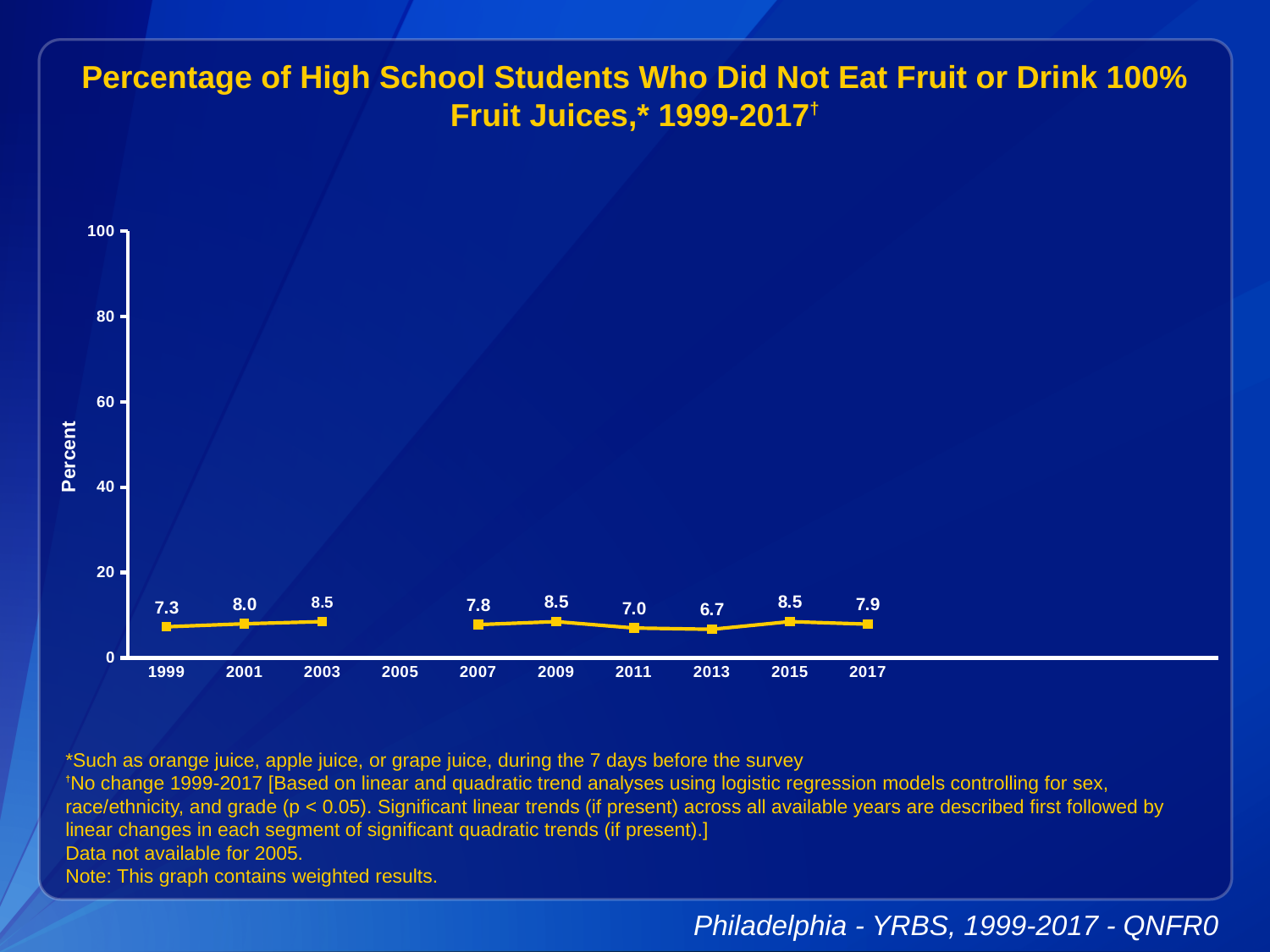
What is the label on the vertical axis? Percent What percentage of high school students did not eat fruit or drink 100% fruit juices in 1999? 7.3 What is the value shown for 2007? 7.8 Is the value for 2009 greater or less than 20? less Which year has the larger value, 2011 or 2015? 2015 What is the value shown for 2013? 6.7 What kind of chart is shown on the slide? line chart What is the difference between the values for 2003 and 1999? 1.2 How many years have a data point plotted on the chart? 9 What is the highest value plotted on the chart? 8.5 What is the value shown for 2017? 7.9 Which year has the lowest value on the chart? 2013